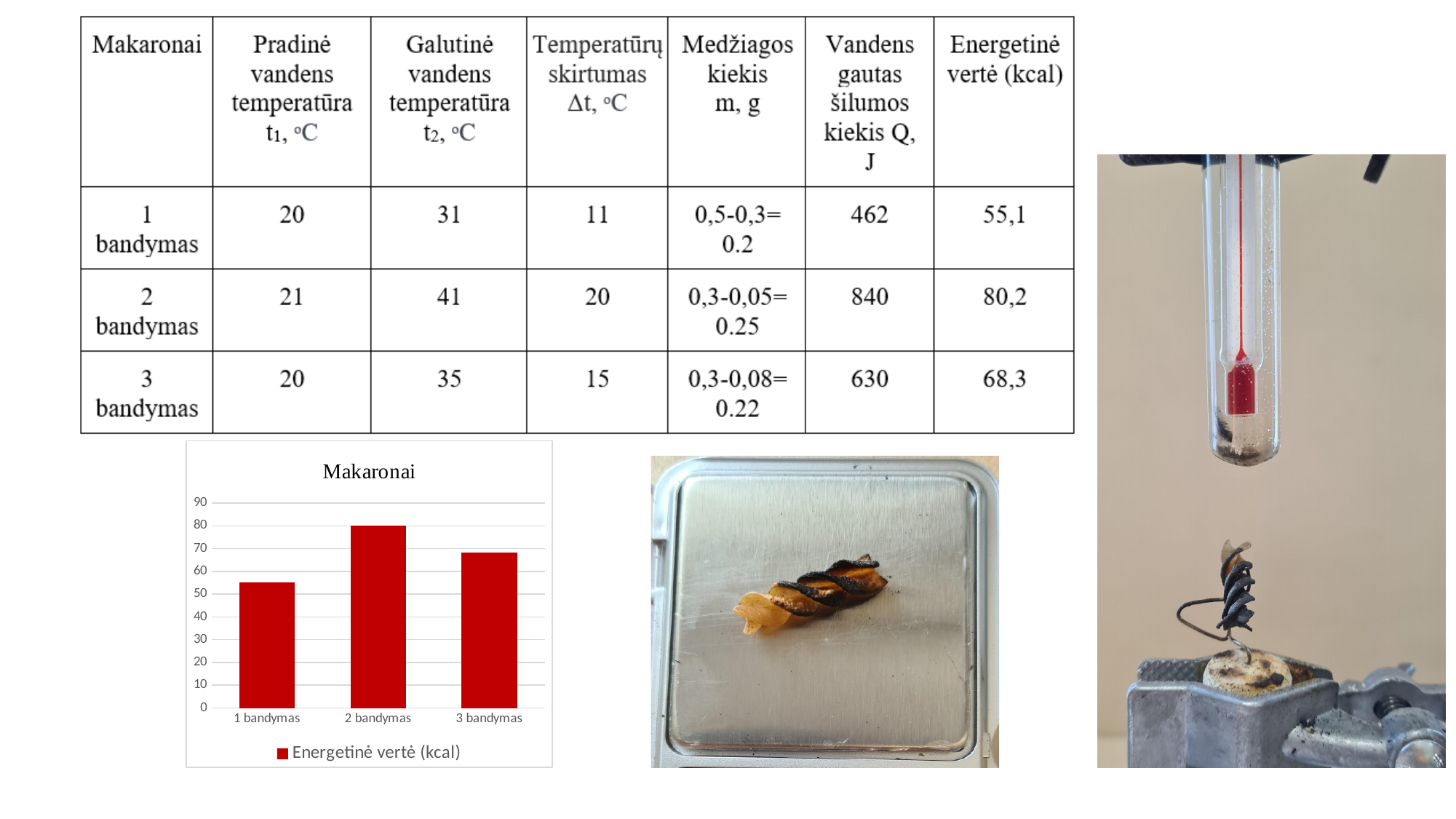
What kind of chart is shown on the slide? bar chart Which category has the lowest bar in the chart? 1 bandymas Is the value for 1 bandymas greater or less than 60? less Which category has the highest bar in the chart? 2 bandymas How many categories are shown on the x axis of the chart? 3 Which is larger in the chart, the value for 3 bandymas or the value for 1 bandymas? 3 bandymas How many series does the chart legend list? 1 Is the value for 2 bandymas greater or less than 70? greater What is the legend entry of the chart? Energetinė vertė (kcal) Which is larger in the chart, the value for 2 bandymas or the value for 3 bandymas? 2 bandymas Is the value for 3 bandymas greater or less than 60? greater What is the title of the chart? Makaronai